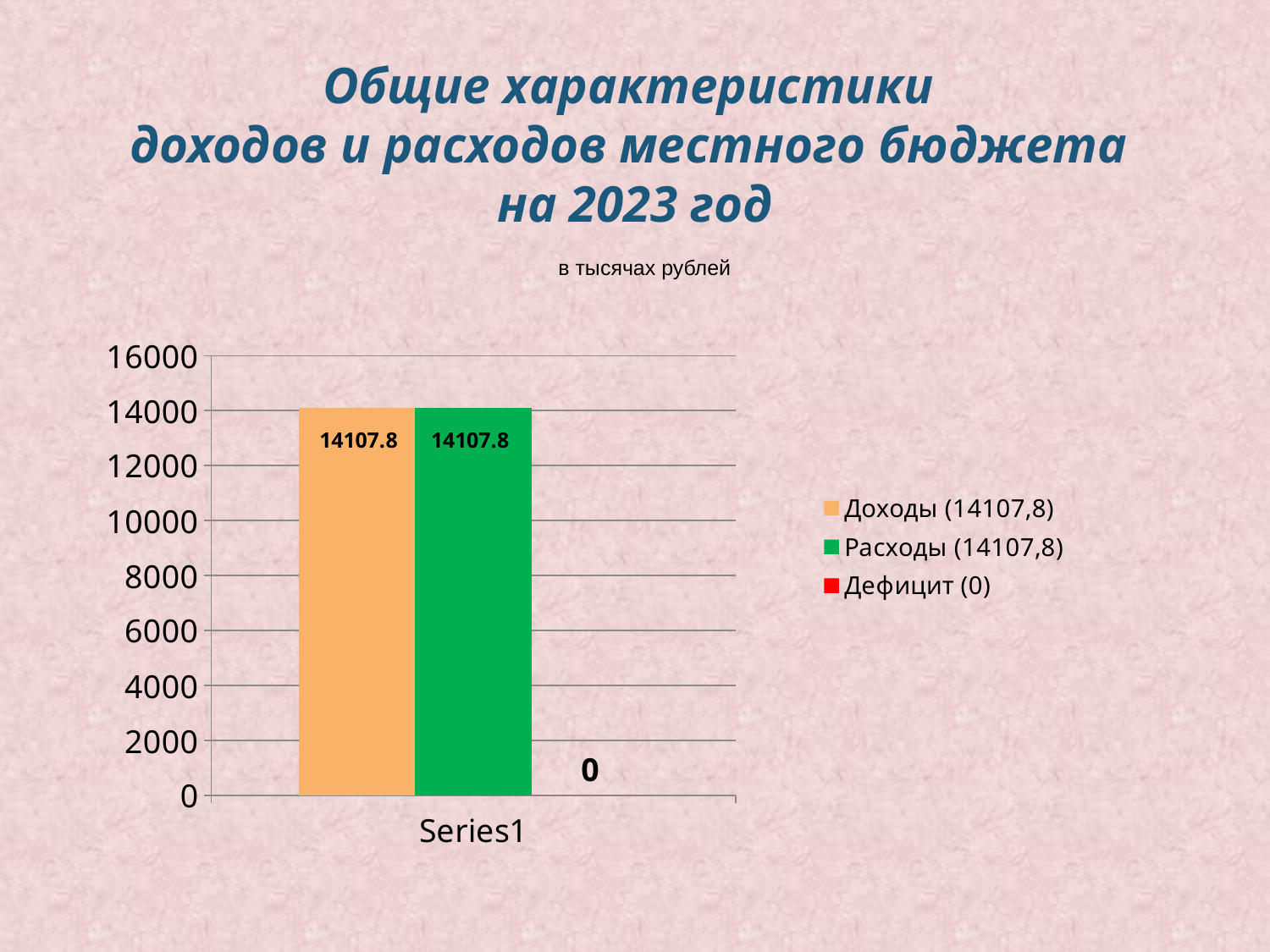
How many series does the legend list? 3 What kind of chart is shown on the slide? bar chart What is the value shown for Дефицит? 0 What colour is the Расходы bar? green What unit is stated above the chart? в тысячах рублей What is the value of the Расходы bar? 14107.8 What is the difference between the Доходы value and the Дефицит value? 14107.8 What is the value of the Доходы bar? 14107.8 Which series has the lowest value? Дефицит Is the value for Расходы greater or less than 16000? less Is the value for Доходы greater or less than 14000? greater What is the difference between the Доходы and Расходы values? 0